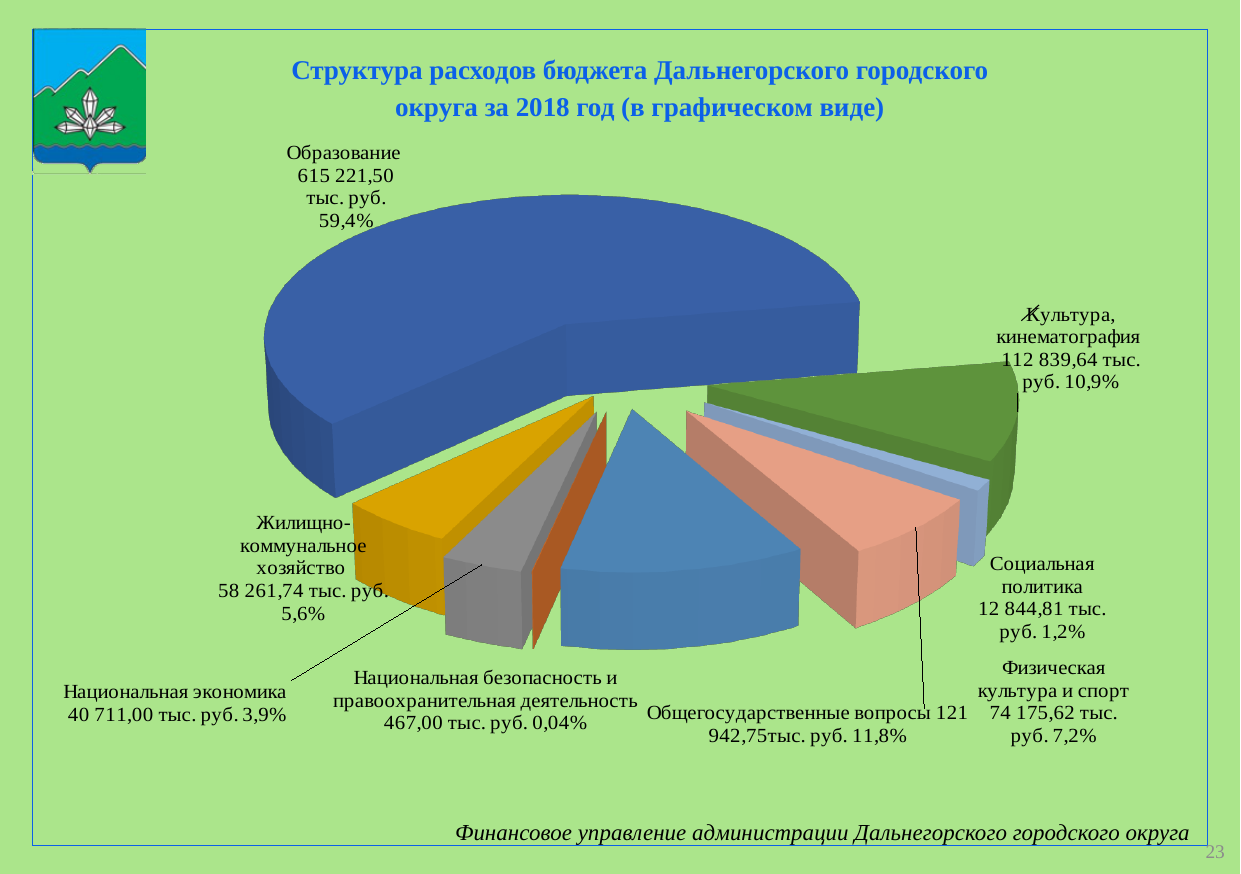
What is the value for Социальная политика? 12 844,81 тыс. руб. What is the title of the chart? Структура расходов бюджета Дальнегорского городского округа за 2018 год (в графическом виде) What is the value for Культура, кинематография? 112 839,64 тыс. руб. Which category has the largest share of the pie? Образование What is the value for Образование? 615 221,50 тыс. руб. Which category has the smallest share of the pie? Национальная безопасность и правоохранительная деятельность Which is larger: the share for Физическая культура и спорт or the share for Жилищно-коммунальное хозяйство? Физическая культура и спорт What share of the pie does Общегосударственные вопросы represent? 11,8% What is the difference in percentage points between the share for Общегосударственные вопросы and the share for Культура, кинематография? 0,9% What kind of chart is shown on the slide? Pie chart How many categories (slices) does the pie chart show? 8 What share of the pie does Образование represent? 59,4%